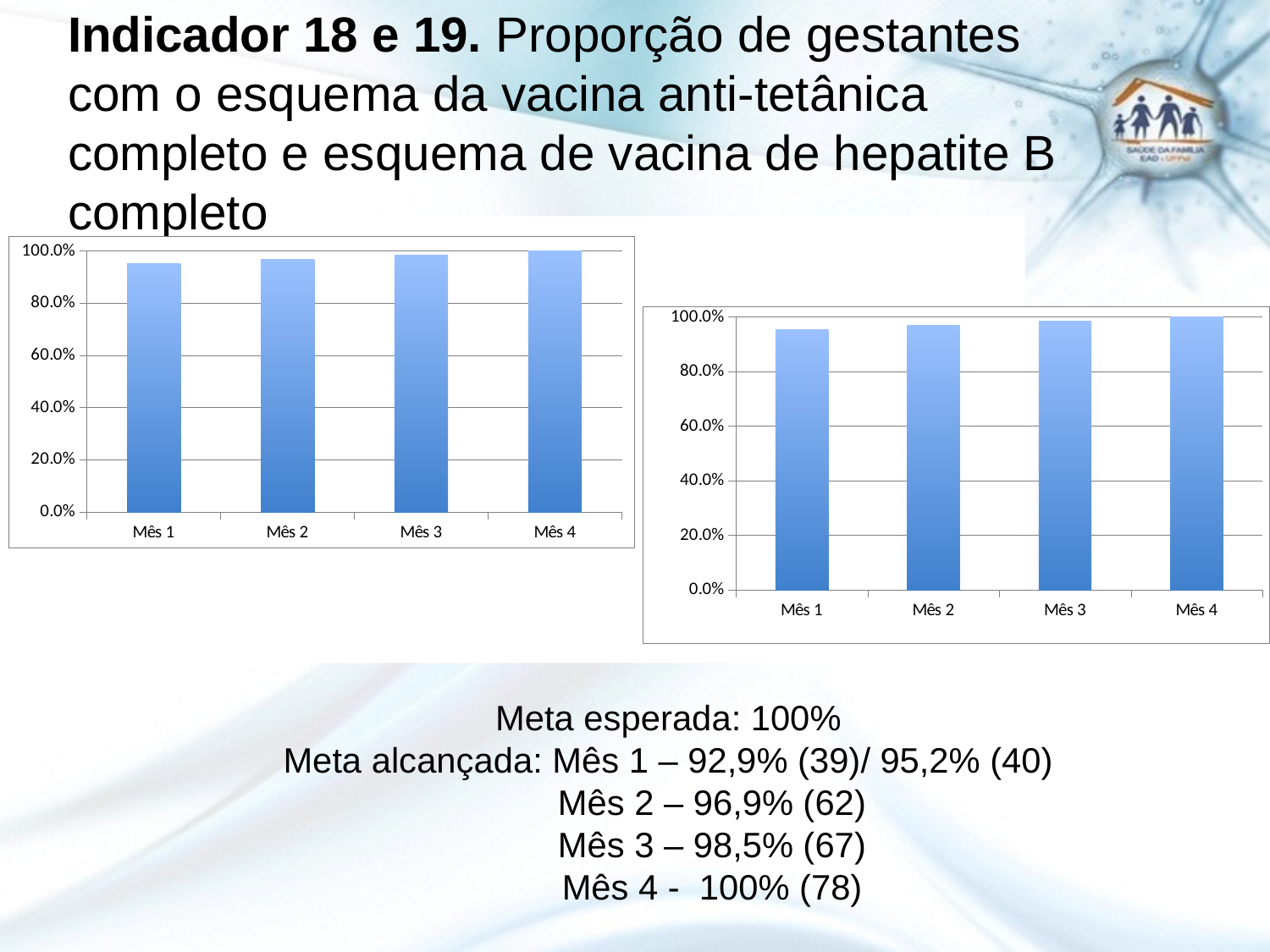
In the chart on the right, what is the value for Mês 4? 100.0% What is the label of the first category on the x axis of the chart on the right? Mês 1 In the chart on the left, is the value for Mês 1 greater or less than 80.0%? greater What kind of chart is the chart on the left of the slide? bar chart What kind of chart is the chart on the right of the slide? bar chart In the chart on the right, is the value for Mês 2 greater or less than 60.0%? greater In the chart on the left, what is the value for Mês 4? 100.0% In the chart on the left, which is larger, the value for Mês 1 or the value for Mês 4? Mês 4 In the chart on the right, do the values rise or fall from Mês 1 to Mês 4? rise How many categories are shown on the x axis of the chart on the right? 4 In the chart on the left, do the values rise or fall from Mês 1 to Mês 4? rise How many categories are shown on the x axis of the chart on the left? 4